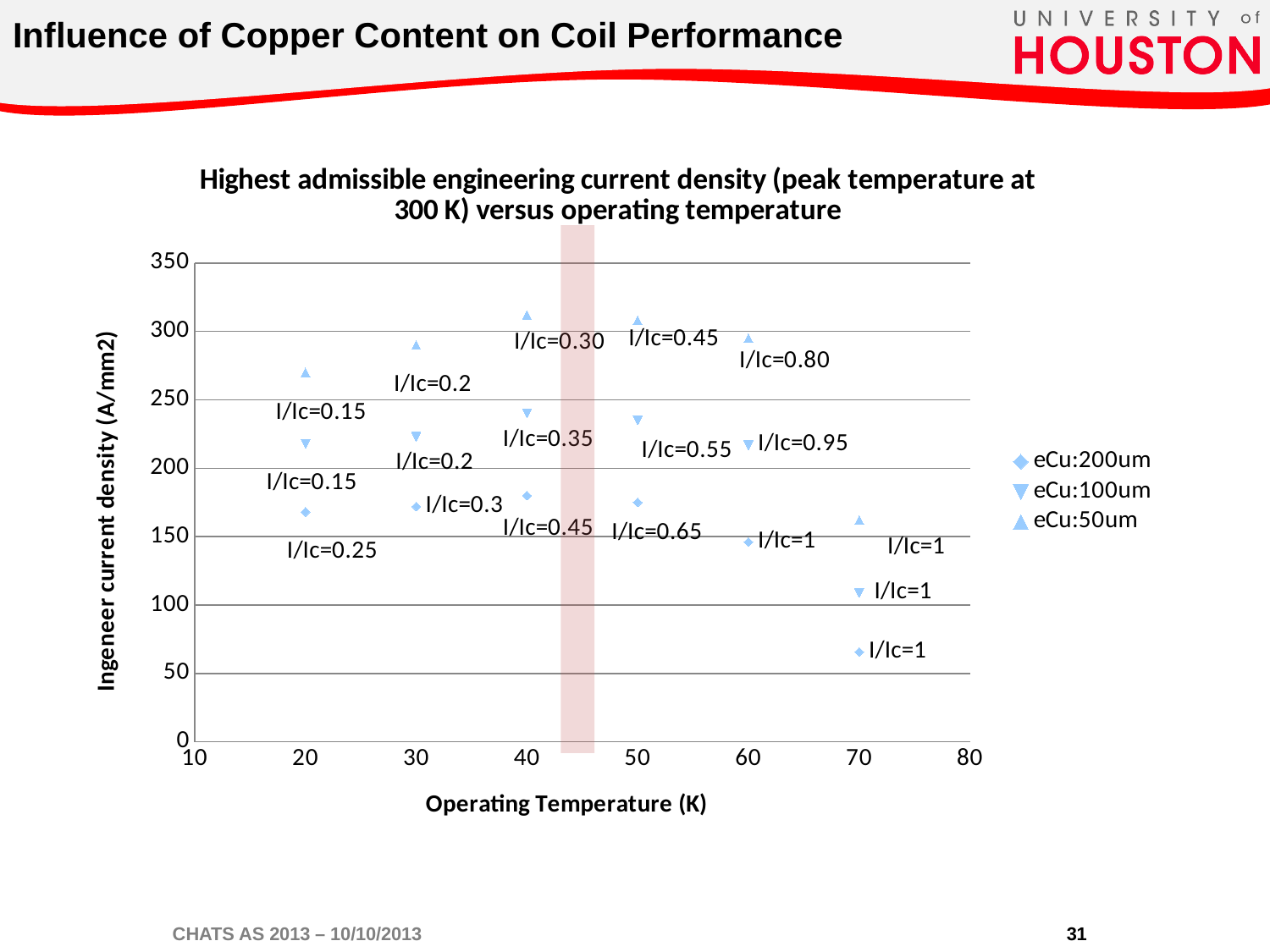
What data label is attached to the eCu:50um point at 60 K? I/Ic=0.80 Which series has the highest current density values across the operating temperatures? eCu:50um What is the title of the x axis? Operating Temperature (K) How many series does the legend list? 3 What kind of chart is shown on the slide? scatter chart Is the value for the eCu:100um series at 40 K greater or less than 200? greater How many data points are plotted for the eCu:200um series? 6 Is the value for the eCu:50um series at 40 K greater or less than 300? greater At 70 K, which series has the larger value, eCu:50um or eCu:200um? eCu:50um Is the value for the eCu:200um series at 70 K greater or less than 100? less What are the three series named in the legend? eCu:200um, eCu:100um, eCu:50um